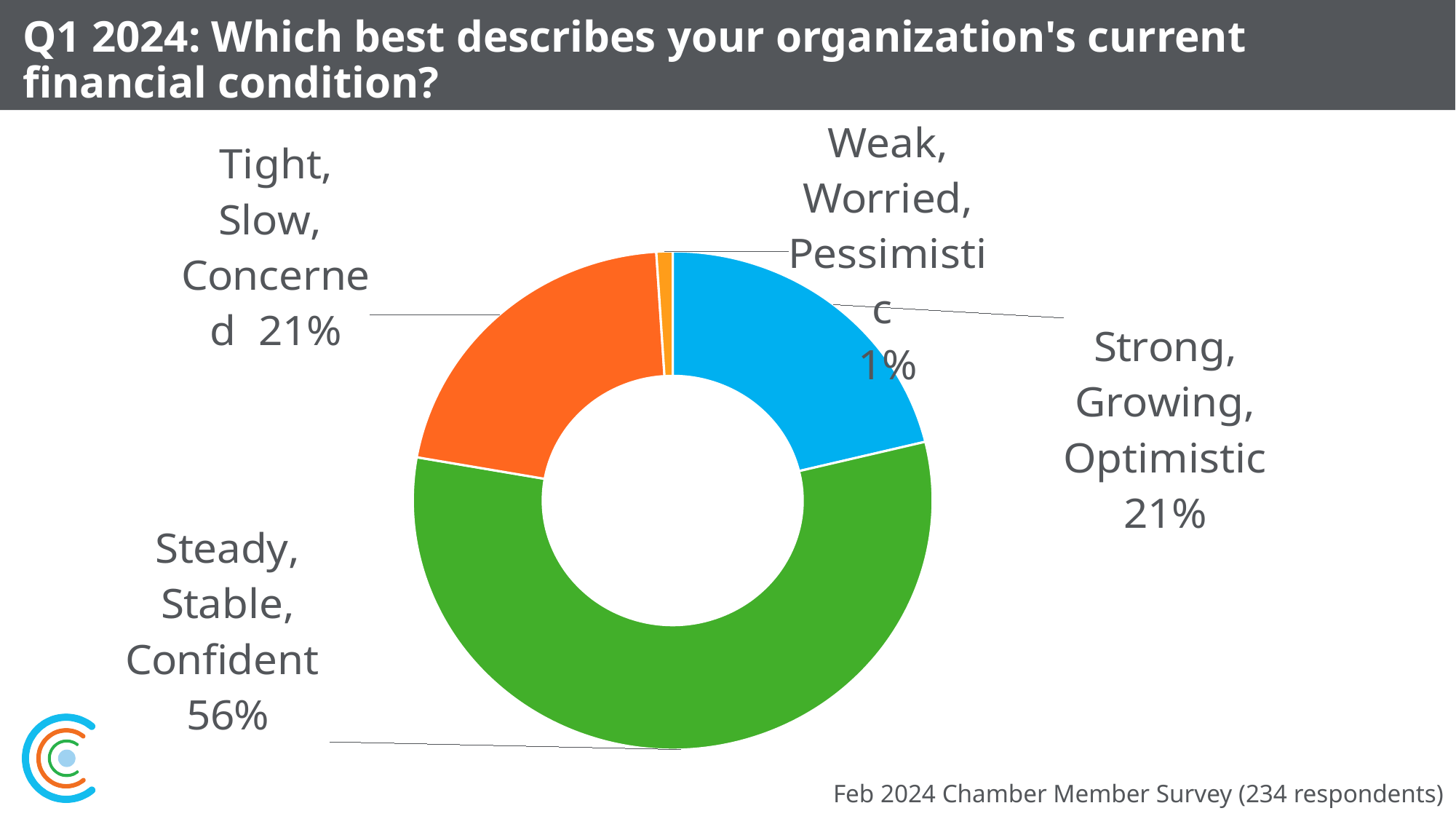
Which category has the largest share of the chart? Steady, Stable, Confident What percentage of respondents chose Strong, Growing, Optimistic? 21% Which is larger: the share for Steady, Stable, Confident or the share for Tight, Slow, Concerned? Steady, Stable, Confident What colour is the Steady, Stable, Confident segment? Green What percentage of respondents chose Weak, Worried, Pessimistic? 1% What percentage of respondents chose Tight, Slow, Concerned? 21% Which category has the smallest share of the chart? Weak, Worried, Pessimistic What kind of chart is shown on the slide? Doughnut (pie) chart How many categories are shown in the chart? 4 How many respondents took part in the survey, according to the slide? 234 What percentage of respondents described their organization's financial condition as Steady, Stable, Confident? 56% What is the difference in percentage points between Steady, Stable, Confident and Strong, Growing, Optimistic? 35